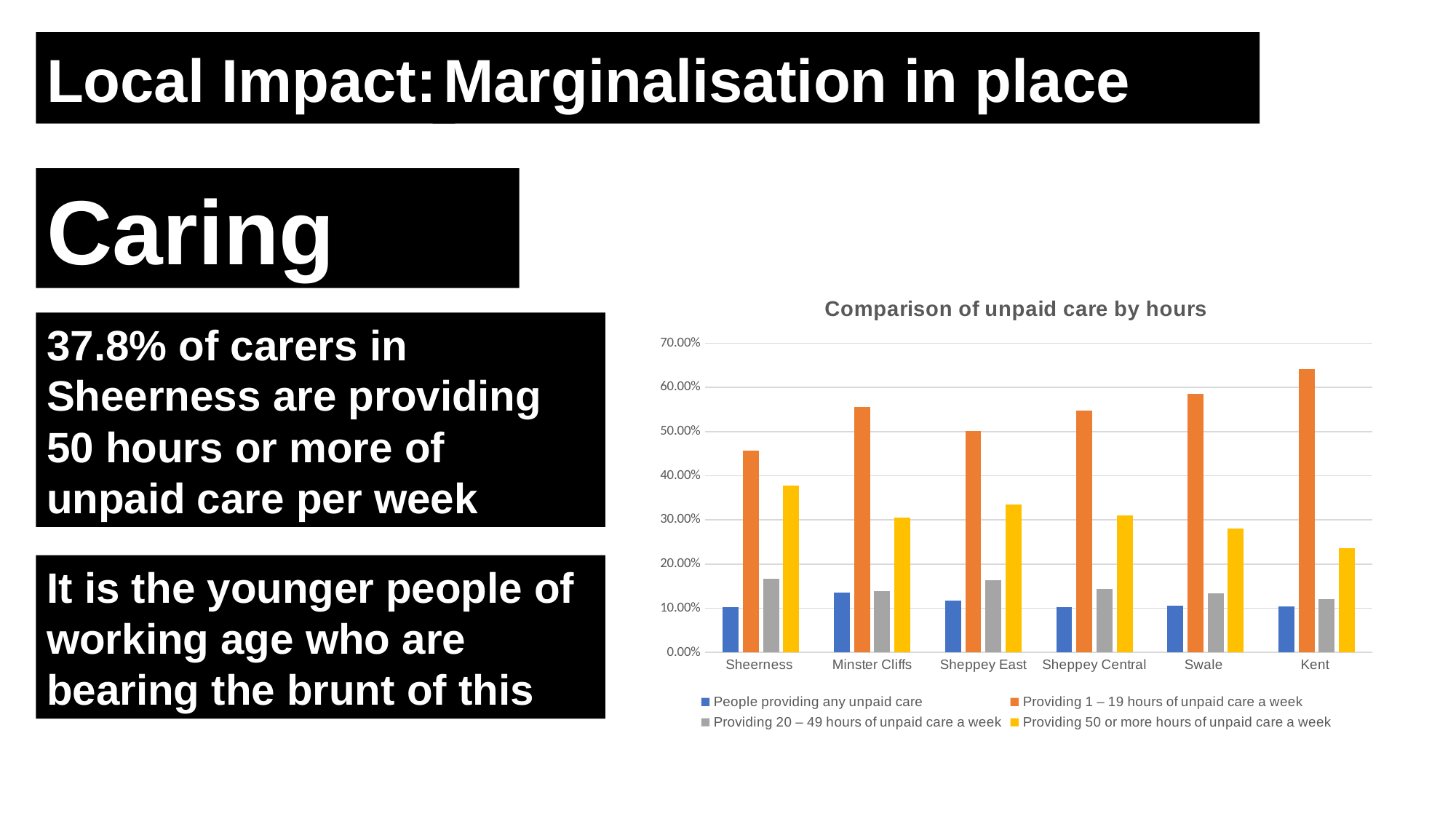
Which area has the lowest value for 'Providing 50 or more hours of unpaid care a week'? Kent Is the value for 'Providing 1 – 19 hours of unpaid care a week' in Sheerness greater or less than 50.00%? less How many series does the chart legend list? 4 Is the value for 'Providing 50 or more hours of unpaid care a week' in Swale greater or less than 30.00%? less How many areas (categories) are shown on the x axis of the chart? 6 What kind of chart is shown on the slide? Bar chart Which area has the highest value for 'Providing 50 or more hours of unpaid care a week'? Sheerness Which is larger for Sheerness: 'Providing 50 or more hours of unpaid care a week' or 'Providing 20 – 49 hours of unpaid care a week'? Providing 50 or more hours of unpaid care a week Which area has the highest value for 'Providing 1 – 19 hours of unpaid care a week'? Kent Is the value for 'Providing 1 – 19 hours of unpaid care a week' in Kent greater or less than 60.00%? greater Which area has the lowest value for 'Providing 1 – 19 hours of unpaid care a week'? Sheerness What is the title of the chart? Comparison of unpaid care by hours